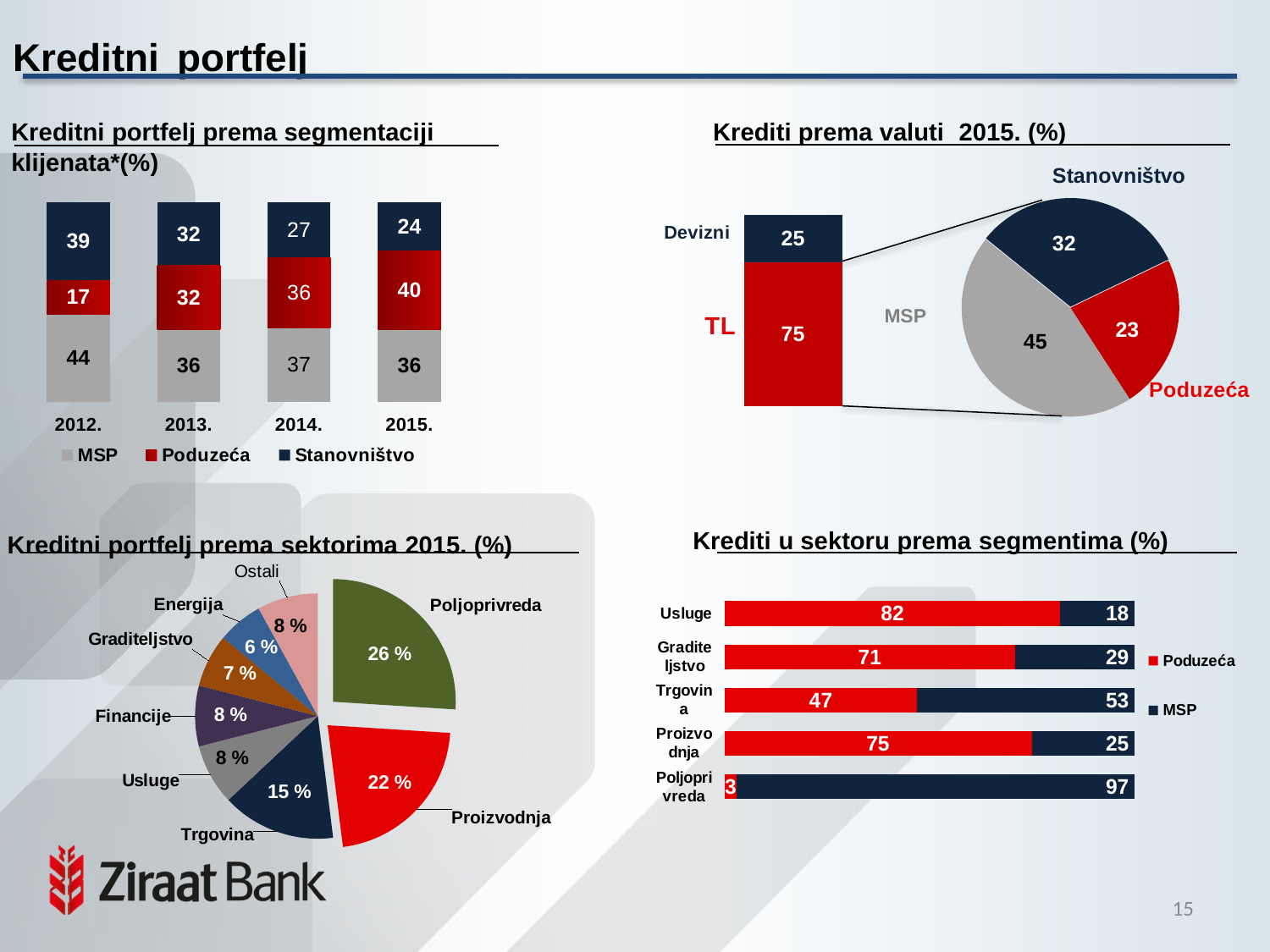
In the chart 'Kreditni portfelj prema segmentaciji klijenata*(%)', what is the value for MSP in 2012.? 44 In the chart 'Krediti u sektoru prema segmentima (%)', which is larger for Trgovina, Poduzeća or MSP? MSP In the chart 'Kreditni portfelj prema segmentaciji klijenata*(%)', what is the value for Poduzeća in 2015.? 40 In the chart 'Kreditni portfelj prema segmentaciji klijenata*(%)', what is the difference between the Poduzeća values for 2013. and 2012.? 15 In the pie of the chart 'Krediti prema valuti 2015. (%)', which segment has the largest share? MSP In the chart 'Kreditni portfelj prema segmentaciji klijenata*(%)', does the Stanovništvo value rise or fall from 2012. to 2015.? fall In the chart 'Krediti prema valuti 2015. (%)', what is the value for TL? 75 How many series does the legend of the chart 'Kreditni portfelj prema segmentaciji klijenata*(%)' list? 3 What kind of chart is 'Kreditni portfelj prema sektorima 2015. (%)'? pie chart In the chart 'Krediti u sektoru prema segmentima (%)', what is the MSP value for Poljoprivreda? 97 In the chart 'Kreditni portfelj prema sektorima 2015. (%)', which sector has the largest share? Poljoprivreda In the chart 'Kreditni portfelj prema sektorima 2015. (%)', what is the share for Proizvodnja? 22 %